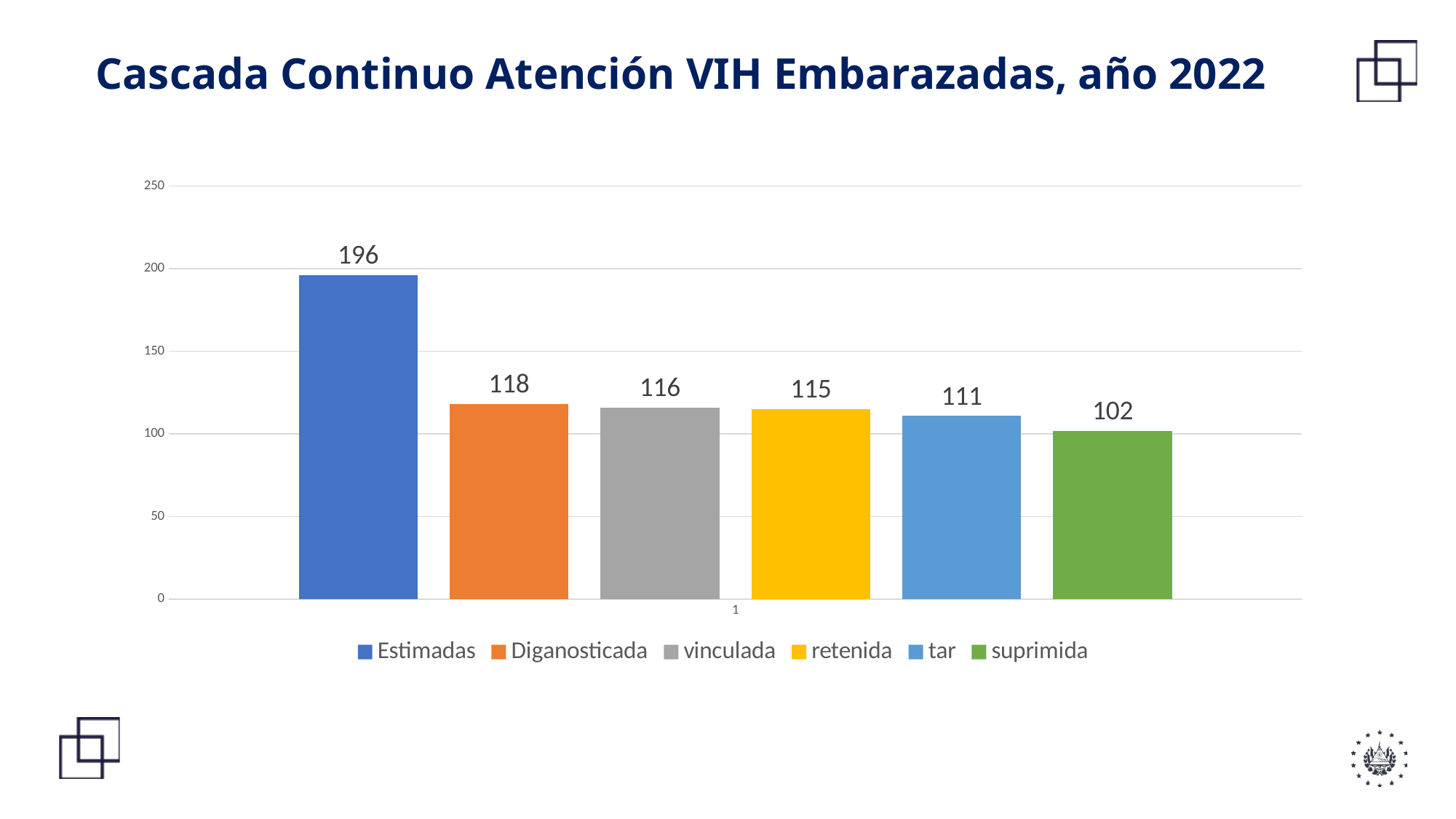
Which series has the lowest value? suprimida What is the difference between the values for retenida and suprimida? 13 Do the values rise or fall from left to right across the bars? Fall Which is larger, the value for vinculada or the value for tar? vinculada What is the value for Diganosticada? 118 Which series has the highest value? Estimadas What is the value for tar? 111 How many series does the legend list? 6 What is the value for suprimida? 102 What is the value for Estimadas? 196 What is the difference between the values for Estimadas and Diganosticada? 78 What kind of chart is shown on the slide? Bar chart